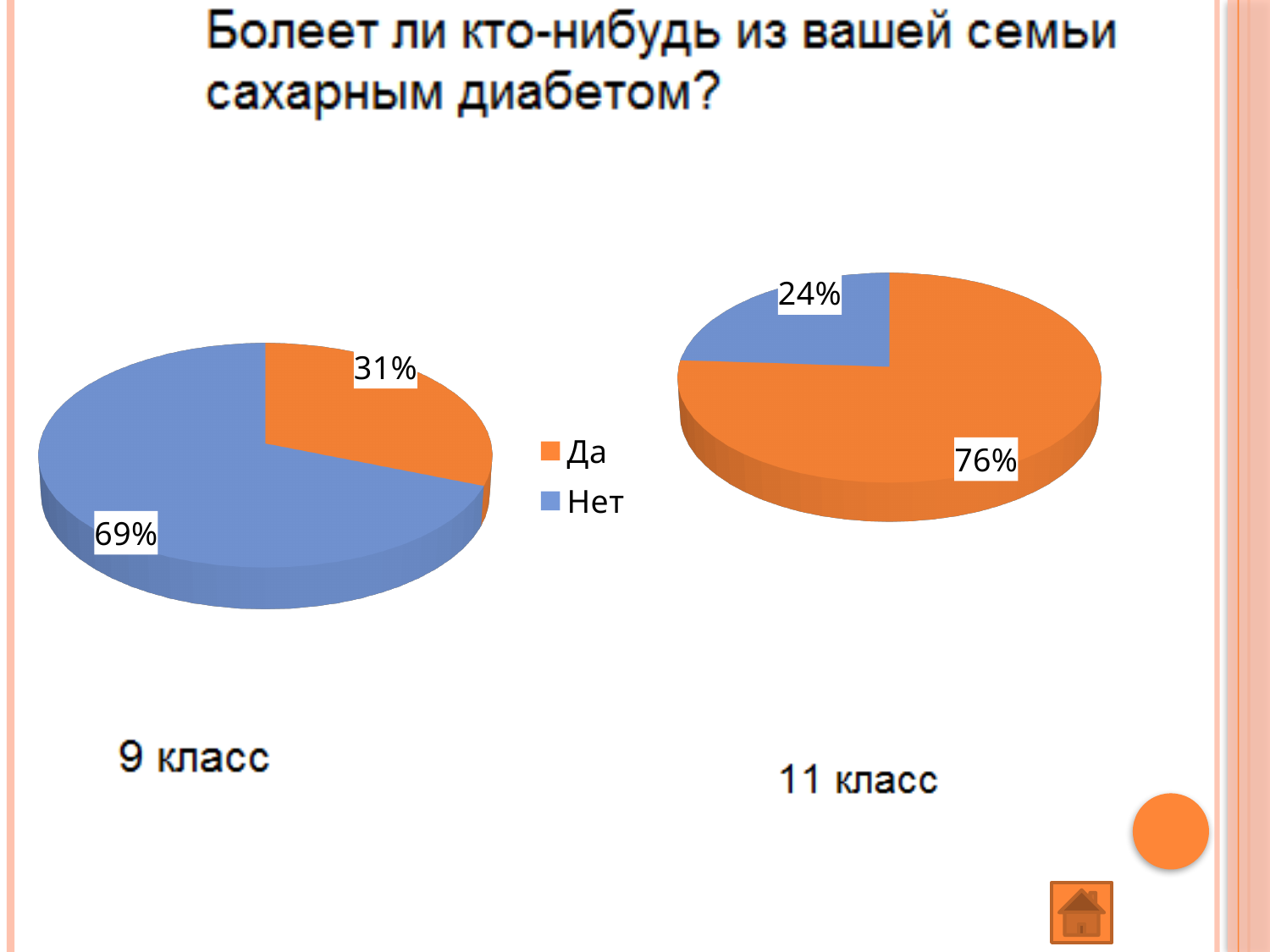
Which colour represents the answer Да in the pie charts? Orange What type of chart is used for the 9 класс data? Pie chart In the 9 класс pie chart, what share of respondents answered Нет? 69% How many categories does the legend list? 2 Which chart has the larger Да share, 9 класс or 11 класс? 11 класс In the 11 класс pie chart, what is the difference between the Да and Нет shares? 52% In the 9 класс pie chart, what share of respondents answered Да? 31% In the 11 класс pie chart, what share of respondents answered Да? 76% In the 9 класс pie chart, what is the difference between the Нет and Да shares? 38% In the 9 класс pie chart, which answer has the largest slice? Нет In the 11 класс pie chart, what share of respondents answered Нет? 24% In the 11 класс pie chart, which answer has the smallest slice? Нет